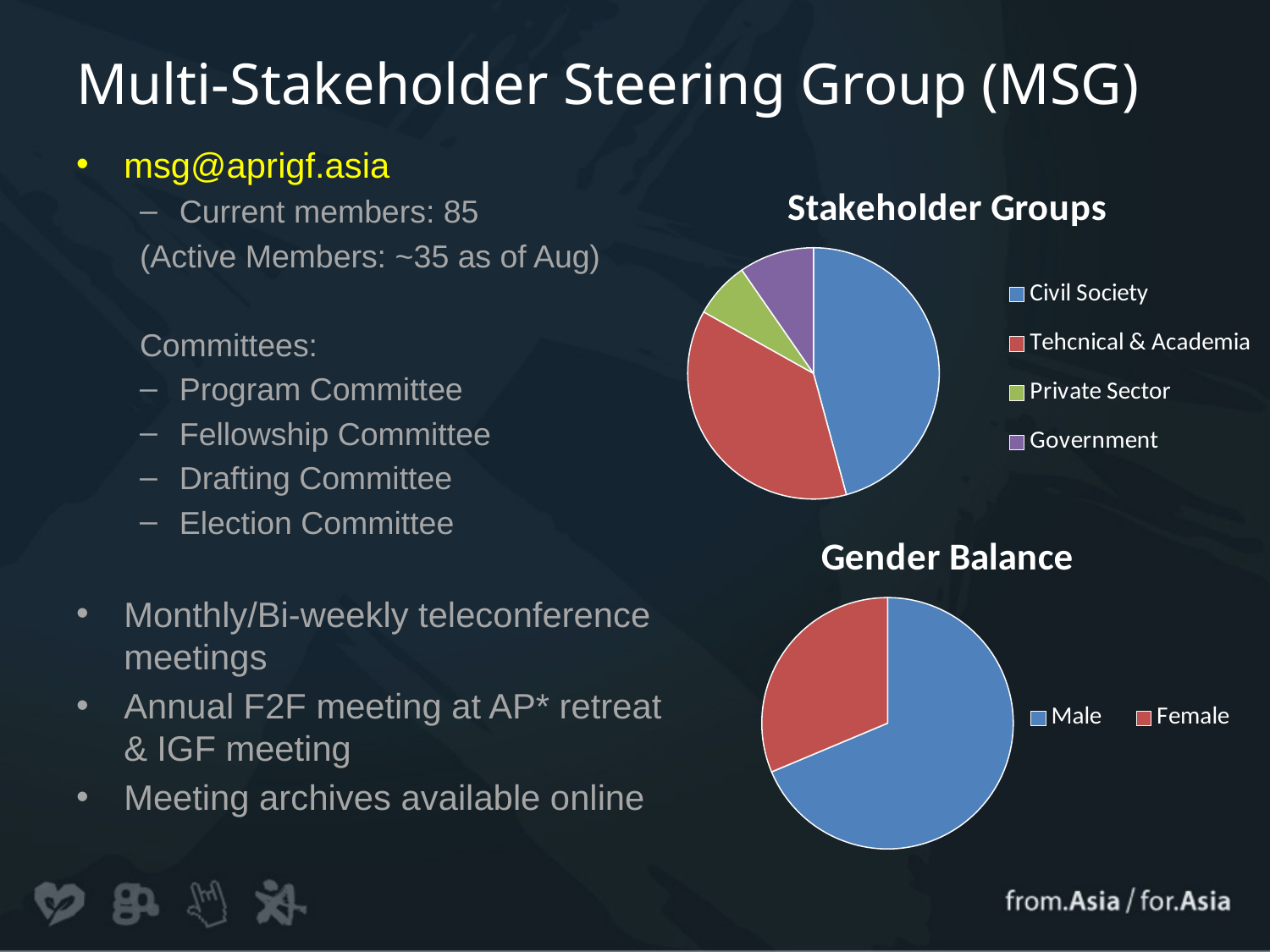
In the Gender Balance chart, which slice is larger, Male or Female? Male In the Stakeholder Groups chart, which slice is larger, Tehcnical & Academia or Private Sector? Tehcnical & Academia What kind of chart is the Stakeholder Groups chart? pie chart What kind of chart is the Gender Balance chart? pie chart In the Stakeholder Groups chart, which colour represents Government? purple In the Stakeholder Groups chart, which stakeholder group has the largest slice? Civil Society In the Gender Balance chart, which category has the smallest slice? Female In the Gender Balance chart, how many categories does the legend list? 2 What is the title of the lower pie chart on the slide? Gender Balance In the Stakeholder Groups chart, which slice is larger, Civil Society or Tehcnical & Academia? Civil Society In the Stakeholder Groups chart, how many categories does the legend list? 4